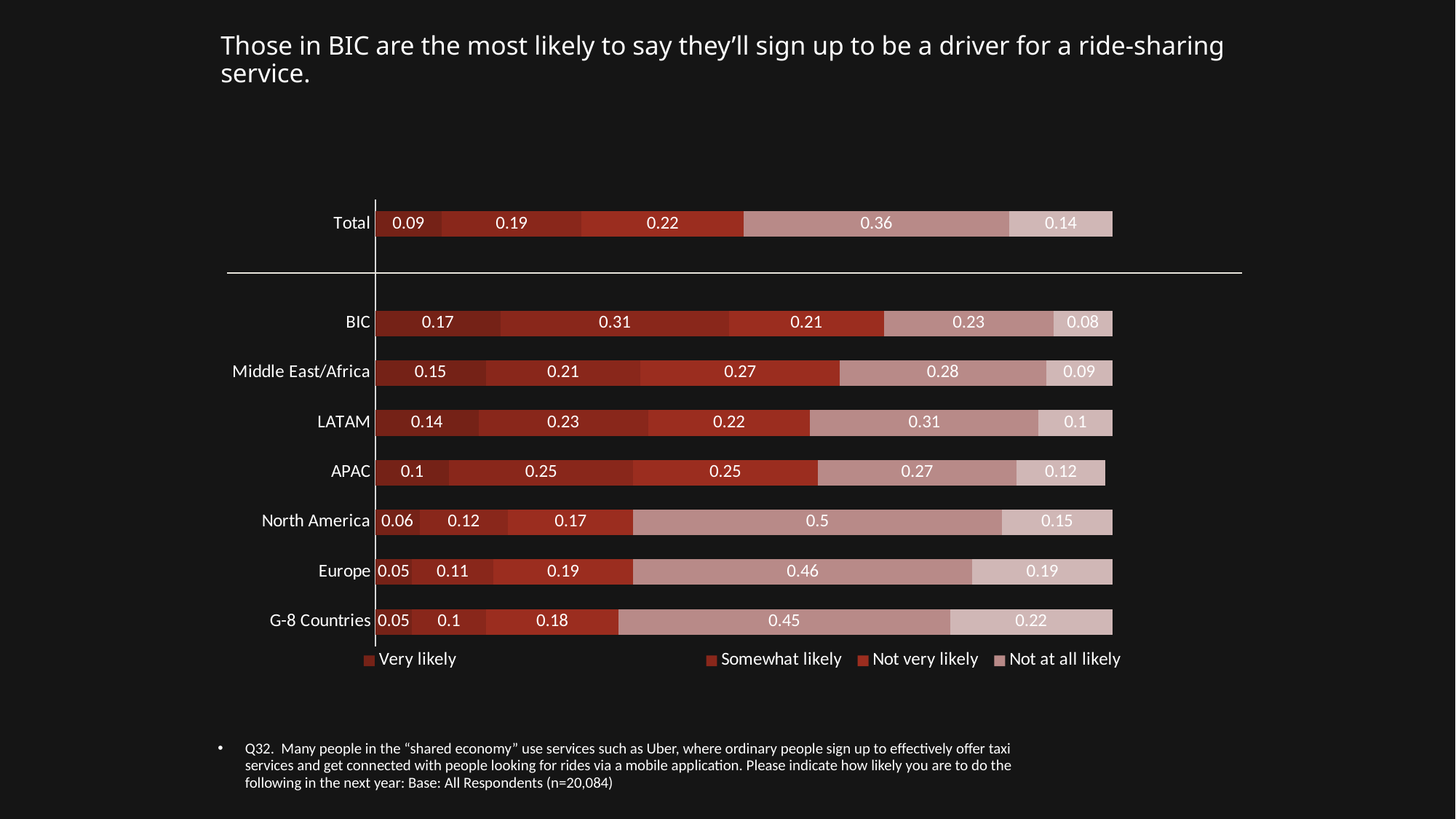
Which region has the highest Somewhat likely value? BIC Which has a larger Very likely value, APAC or North America? APAC Which region has the highest Very likely value? BIC What is the Very likely value for Total? 0.09 What is the Very likely value for BIC? 0.17 What is the Very likely value for North America? 0.06 What is the Somewhat likely value for Middle East/Africa? 0.21 What is the first legend entry of the chart? Very likely What is the difference between the Very likely value for BIC and for Total? 0.08 What kind of chart is shown on the slide? Stacked bar chart How many categories (bars) are shown in the chart, including Total? 8 How many series does the legend list? 4